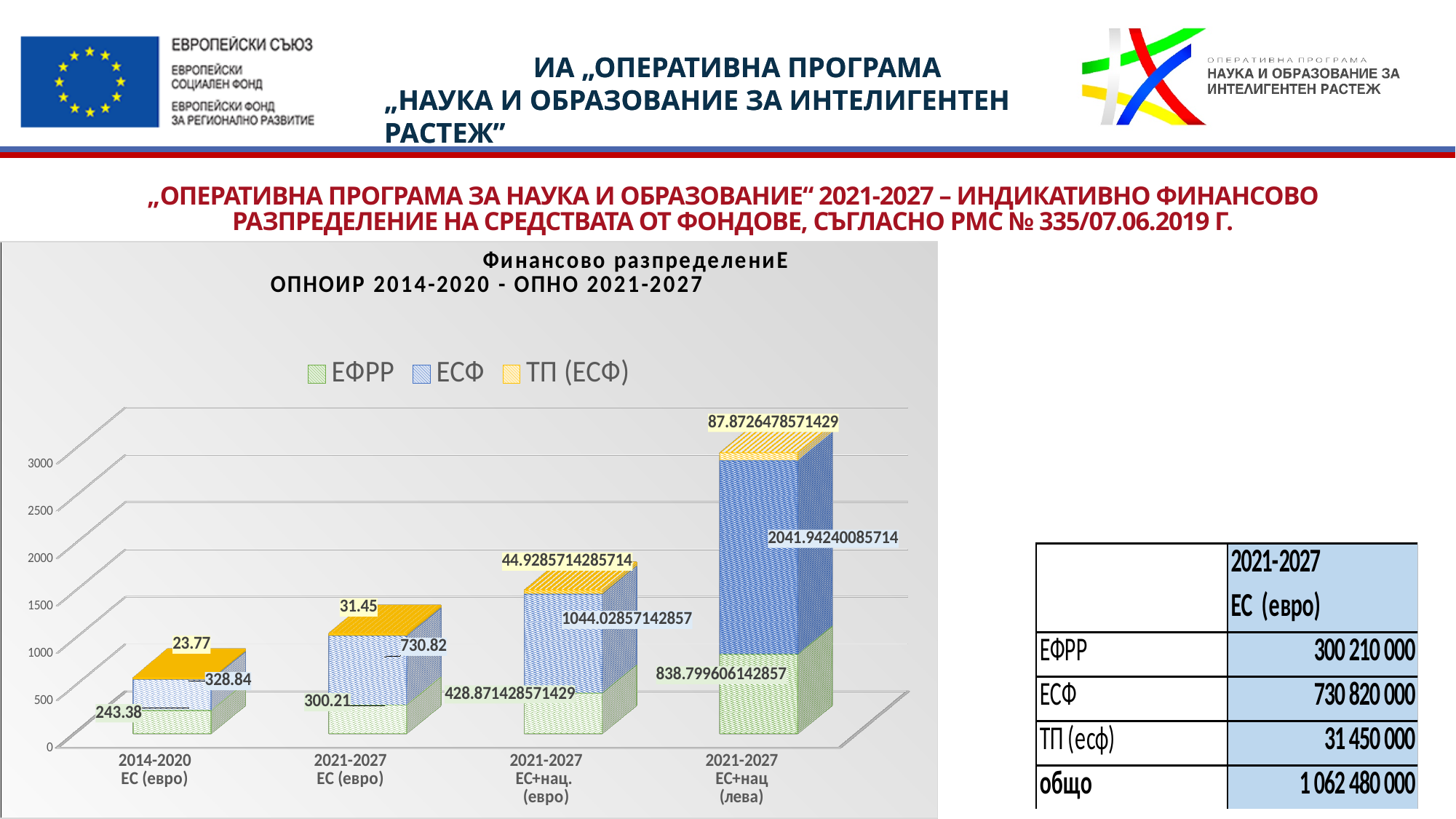
What is the difference between the ЕСФ values for 2021-2027 ЕС (евро) and 2014-2020 ЕС (евро)? 401.98 Which category has the lowest ЕФРР value? 2014-2020 ЕС (евро) What type of chart is shown on the slide? Stacked bar chart What is the ЕСФ value for the 2021-2027 ЕС (евро) category? 730.82 Which is larger, the ТП (ЕСФ) value for 2021-2027 ЕС (евро) or for 2014-2020 ЕС (евро)? 2021-2027 ЕС (евро) What is the ТП (ЕСФ) value for the 2021-2027 ЕС+нац (лева) category? 87.8726478571429 How many series does the chart legend list? 3 What is the ЕФРР value for the 2014-2020 ЕС (евро) category? 243.38 What is the total of the stacked bar for 2021-2027 ЕС (евро)? 1062.48 How many categories are shown on the x axis of the chart? 4 Do the stacked bar totals rise or fall from left to right along the x axis? Rise Which category has the highest ЕСФ value? 2021-2027 ЕС+нац (лева)